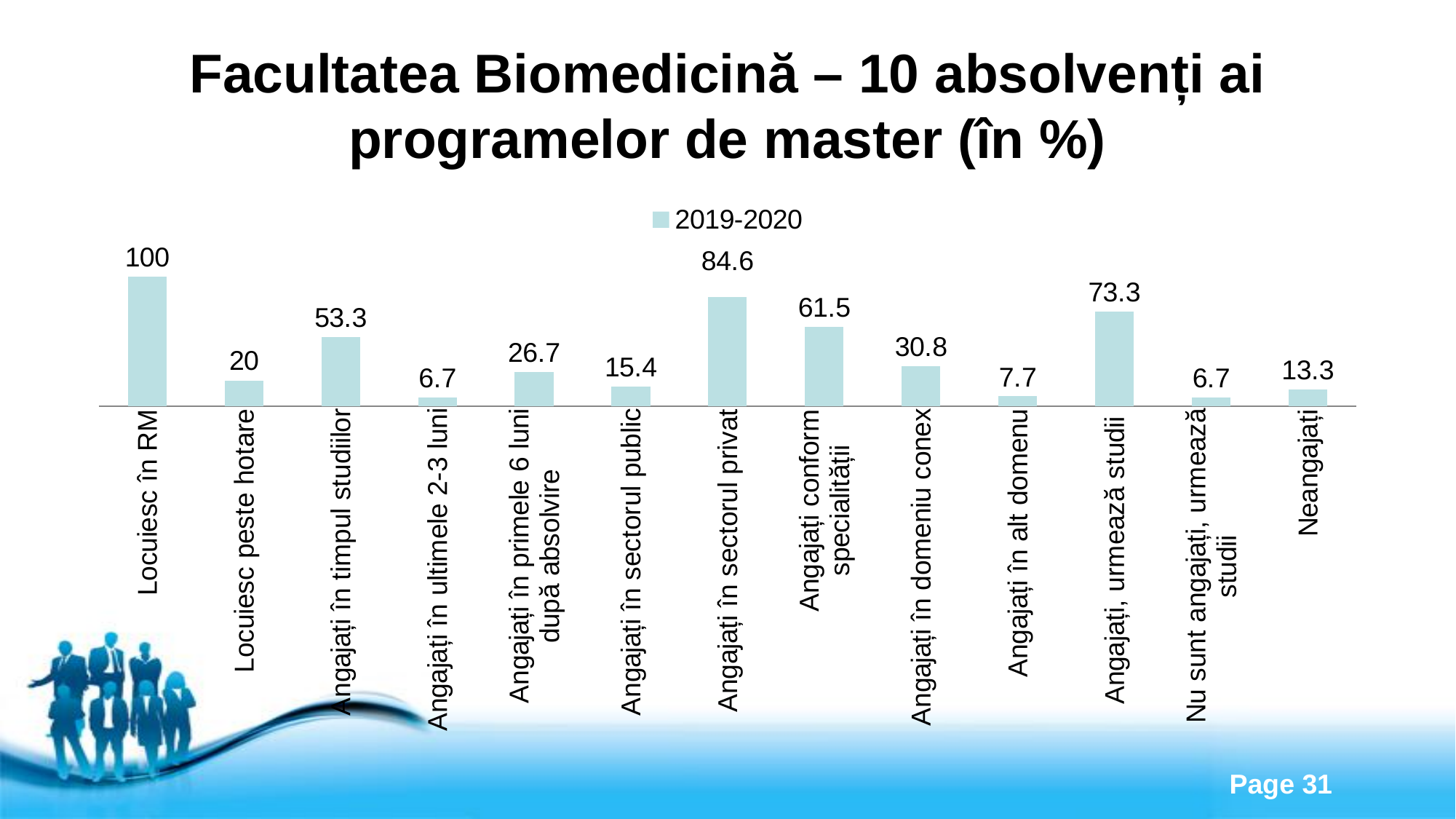
What is the value for "Angajați în sectorul privat"? 84.6 What is the difference between "Angajați în timpul studiilor" and "Angajați în primele 6 luni după absolvire"? 26.6 Which is larger: "Angajați în domeniu conex" or "Angajați în alt domenu"? Angajați în domeniu conex Which is larger: "Angajați, urmează studii" or "Angajați conform specialității"? Angajați, urmează studii What is the value for "Locuiesc peste hotare"? 20 Which category has the highest value? Locuiesc în RM What kind of chart is shown on the slide? Bar chart How many categories are shown on the chart? 13 What is the value for "Neangajați"? 13.3 How many series does the legend list? 1 What is the value for "Angajați conform specialității"? 61.5 What is the difference between "Angajați în sectorul privat" and "Angajați în sectorul public"? 69.2